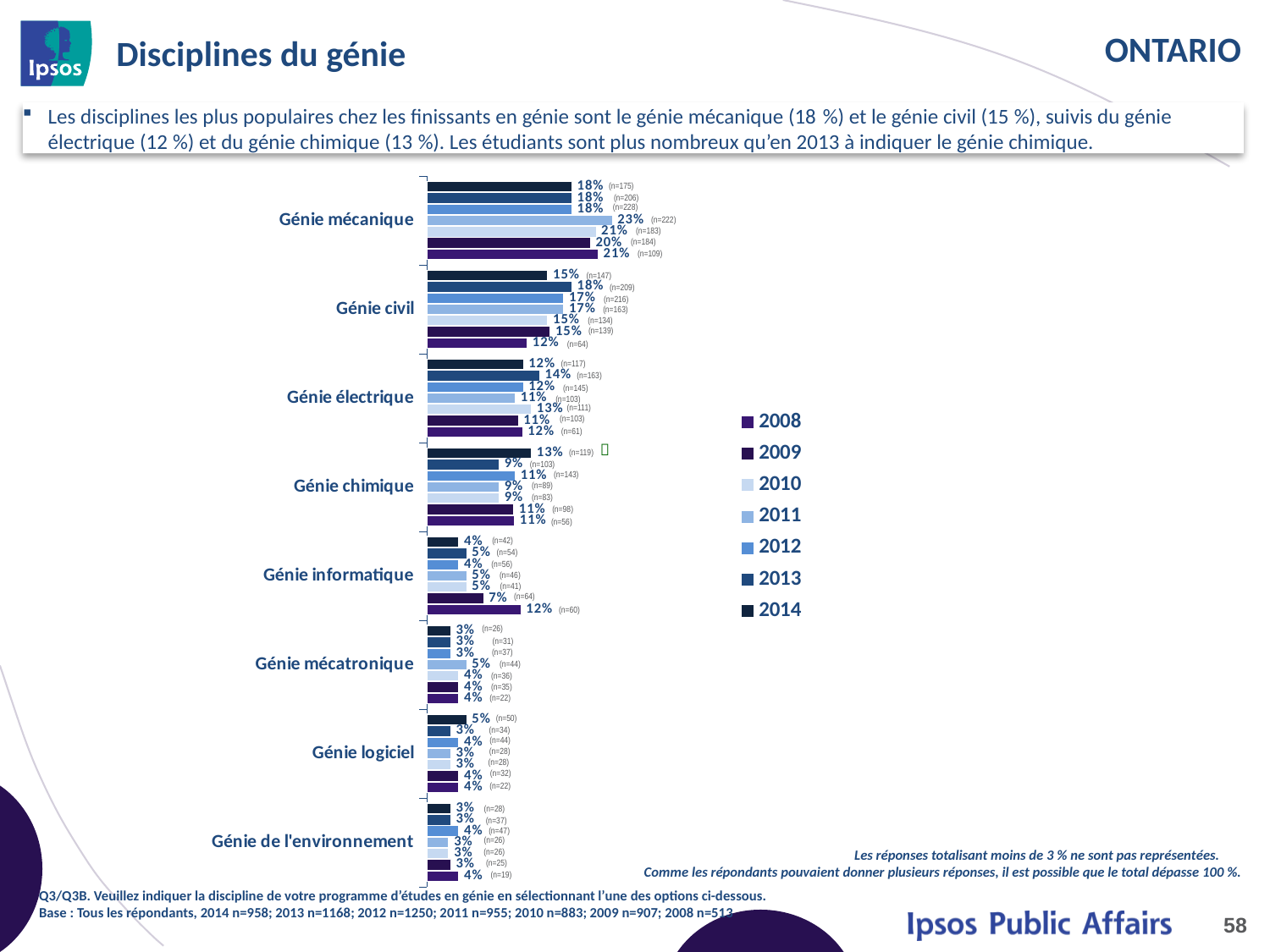
What is the difference between the 2014 and 2013 values for Génie chimique? 4 percentage points Which discipline has the highest 2014 value? Génie mécanique What is the 2014 value for Génie civil? 15% Which year is shown in purple in the legend? 2008 What kind of chart is shown on the slide? Bar chart What is the 2014 value for Génie mécanique? 18% Which is larger for Génie civil: the 2013 value or the 2008 value? 2013 What is the 2008 value for Génie informatique? 12% What is the 2011 value for Génie mécanique? 23% How many series (years) does the legend list? 7 How many engineering disciplines are shown on the chart? 8 What is the 2014 value for Génie chimique? 13%